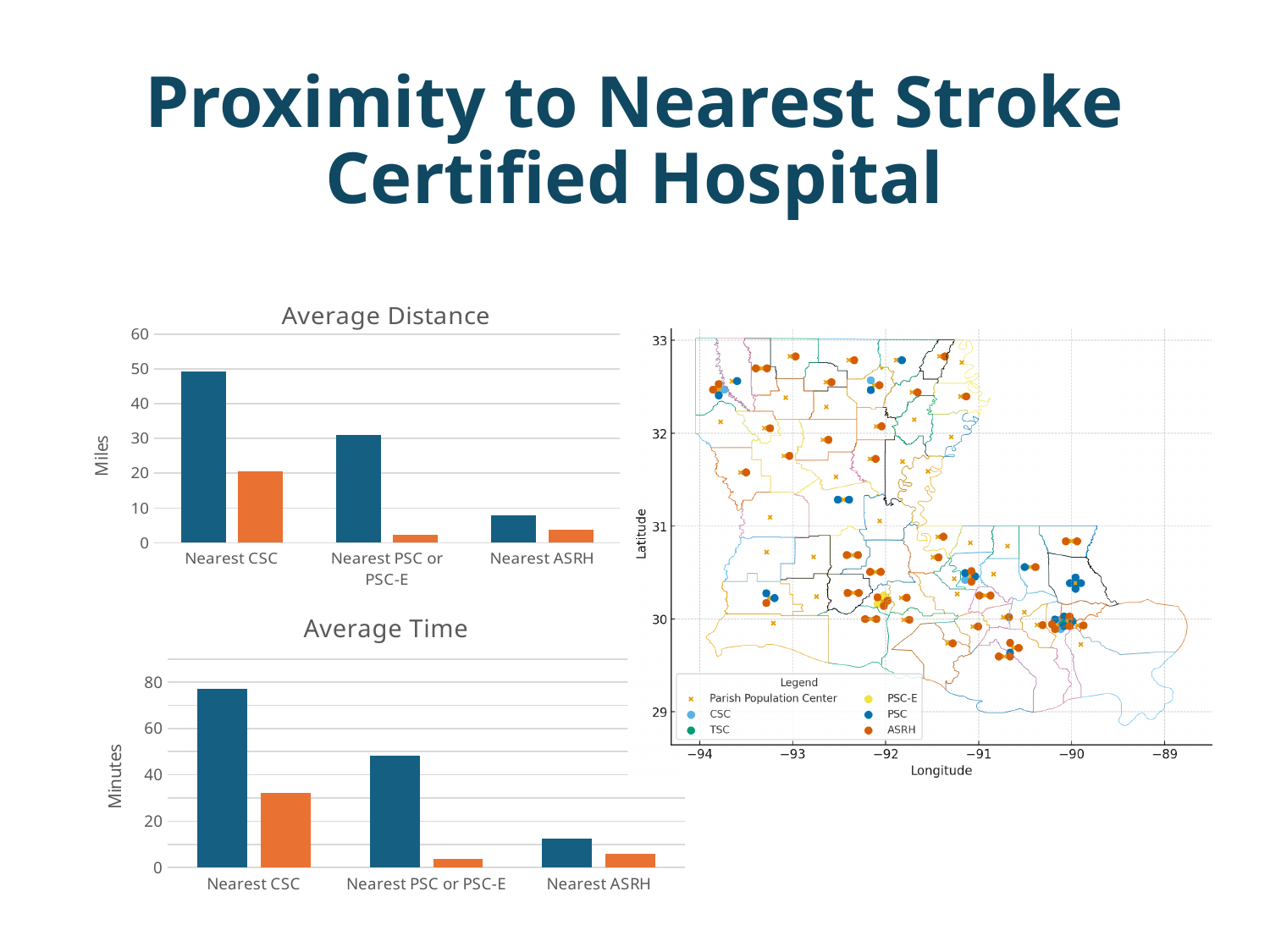
What is the y-axis label of the Average Distance chart? Miles In the Average Distance chart, is the blue bar for Nearest ASRH greater or less than 10? less In the Average Time chart, which has the taller blue bar: Nearest PSC or PSC-E, or Nearest ASRH? Nearest PSC or PSC-E What kind of chart is the Average Distance chart? bar chart In the Average Distance chart, which category has the tallest blue bar? Nearest CSC In the Average Time chart, is the blue bar for Nearest CSC greater or less than 60? greater How many categories are shown on the x axis of the Average Distance chart? 3 In the Average Distance chart, is the blue bar for Nearest CSC greater or less than 40? greater How many categories are shown on the x axis of the Average Time chart? 3 What is the y-axis label of the Average Time chart? Minutes In the Average Time chart, which category has the shortest blue bar? Nearest ASRH